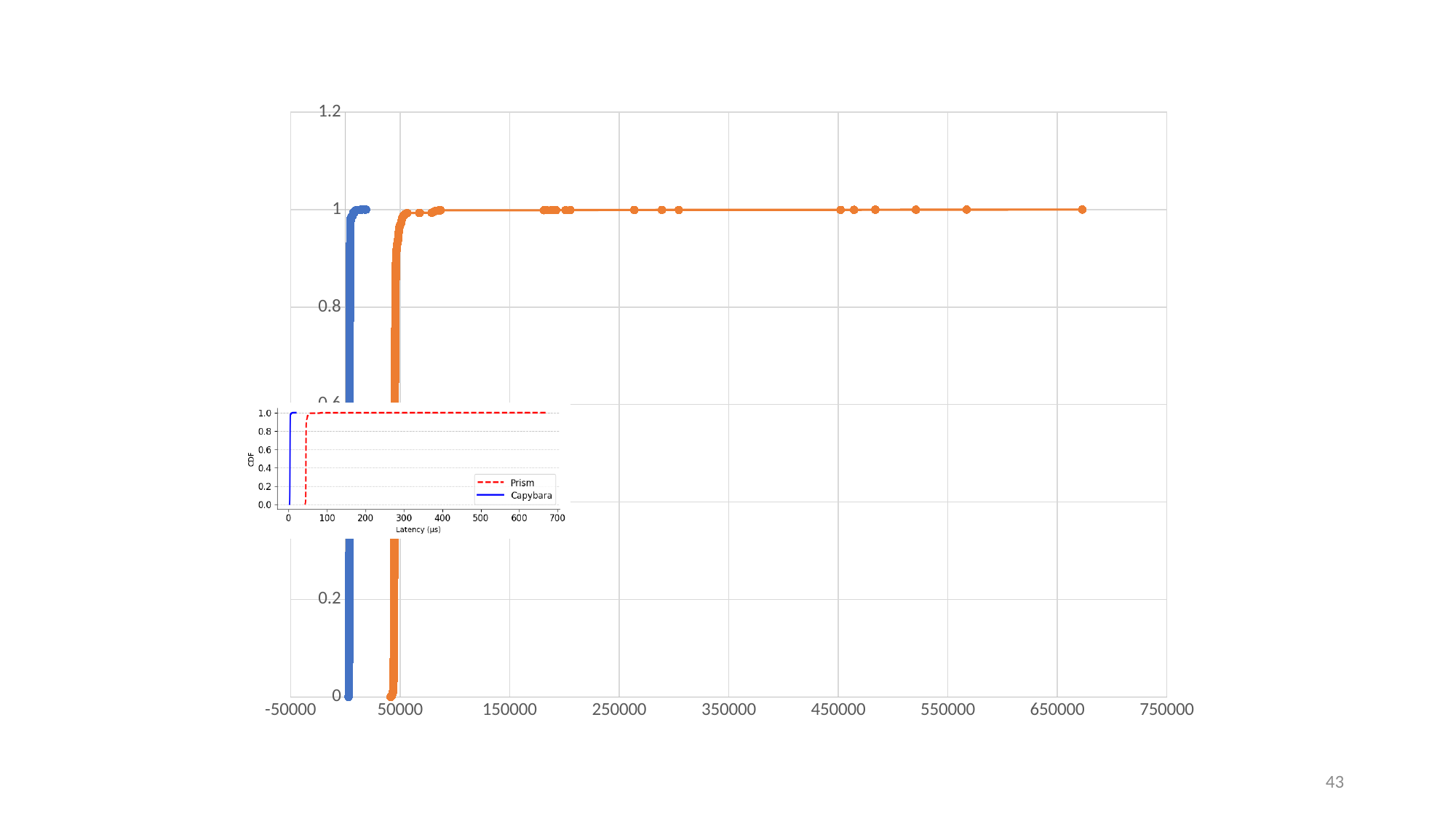
What kind of chart is the large chart on the slide? scatter chart In the large chart, which series extends further to the right along the horizontal axis, the blue or the orange? orange In the large chart, is the rightmost orange point greater or less than 650000 on the horizontal axis? greater In the large chart, what is the highest value shown on the vertical axis? 1.2 In the inset chart, which series reaches a CDF of 1.0 at a lower latency, Prism or Capybara? Capybara In the large chart, what is the leftmost tick label on the horizontal axis? -50000 In the inset chart, how many series does the legend list? 2 In the large chart, is the rightmost blue point greater or less than 50000 on the horizontal axis? less In the inset chart, what is the label of the horizontal axis? Latency (μs) In the large chart, do the plotted values rise or fall as you move along the horizontal axis? rise In the inset chart, is the latency at which Prism reaches a CDF of 1.0 greater or less than 100? less In the large chart, how many data series are plotted? 2